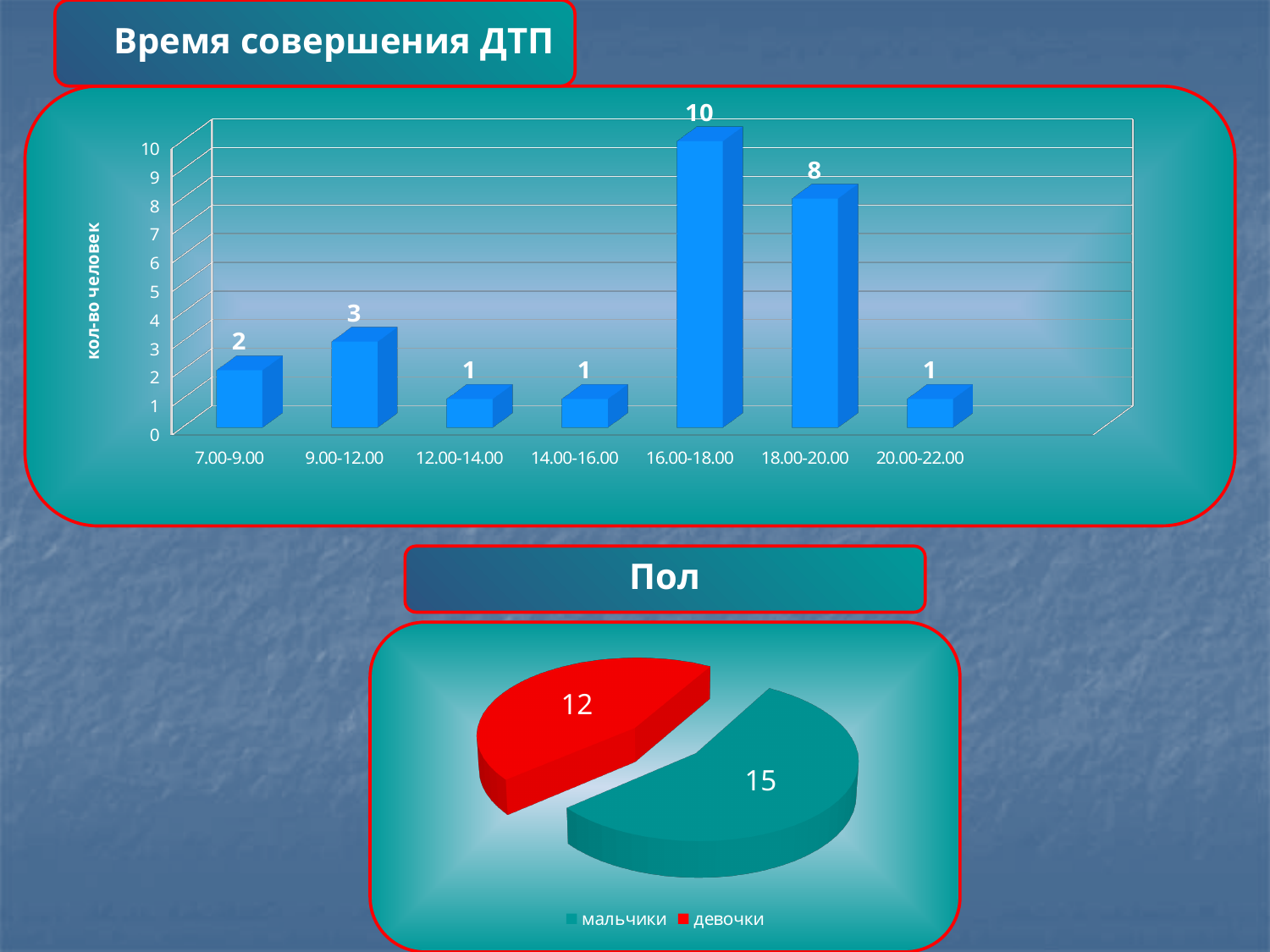
In the 'Время совершения ДТП' chart, which is larger: the value for 7.00-9.00 or the value for 9.00-12.00? 9.00-12.00 In the 'Пол' pie chart, what is the value for мальчики? 15 How many entries does the legend of the 'Пол' pie chart list? 2 How many time intervals are shown in the 'Время совершения ДТП' chart? 7 In the 'Пол' pie chart, what is the value for девочки? 12 In the 'Пол' pie chart, which category has the larger slice? мальчики In the 'Время совершения ДТП' chart, what is the difference between the values for 16.00-18.00 and 18.00-20.00? 2 In the 'Время совершения ДТП' chart, what is the value for 9.00-12.00? 3 In the 'Время совершения ДТП' chart, which time interval has the highest value? 16.00-18.00 In the 'Время совершения ДТП' chart, what is the value for 16.00-18.00? 10 In the 'Время совершения ДТП' chart, what is the label of the vertical axis? кол-во человек What kind of chart is the 'Время совершения ДТП' chart? bar chart